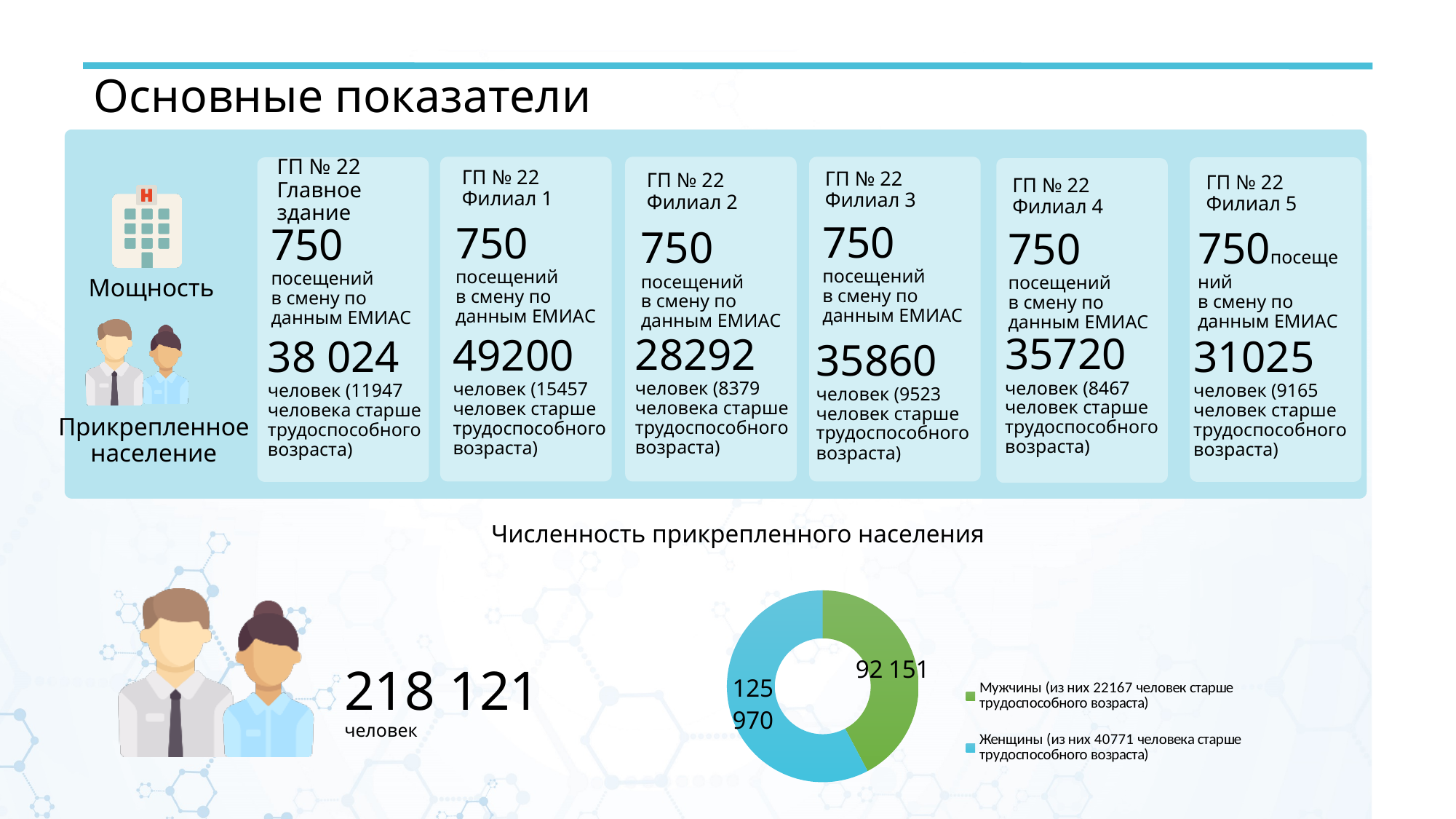
What is the total of the two slices in the pie chart? 218 121 How many entries does the legend of the pie chart list? 2 Which category has the largest slice in the pie chart? Женщины What is the value for Мужчины in the pie chart? 92 151 How many slices does the pie chart have? 2 What kind of chart is shown under the heading "Численность прикрепленного населения"? pie chart (donut) What colour is the Мужчины slice in the pie chart? green In the pie chart, which is larger: Мужчины or Женщины? Женщины Which category has the smallest slice in the pie chart? Мужчины What is the difference between the Женщины and Мужчины values in the pie chart? 33 819 What share of the pie chart does the Женщины slice represent? 57.8% What is the value for Женщины in the pie chart? 125 970